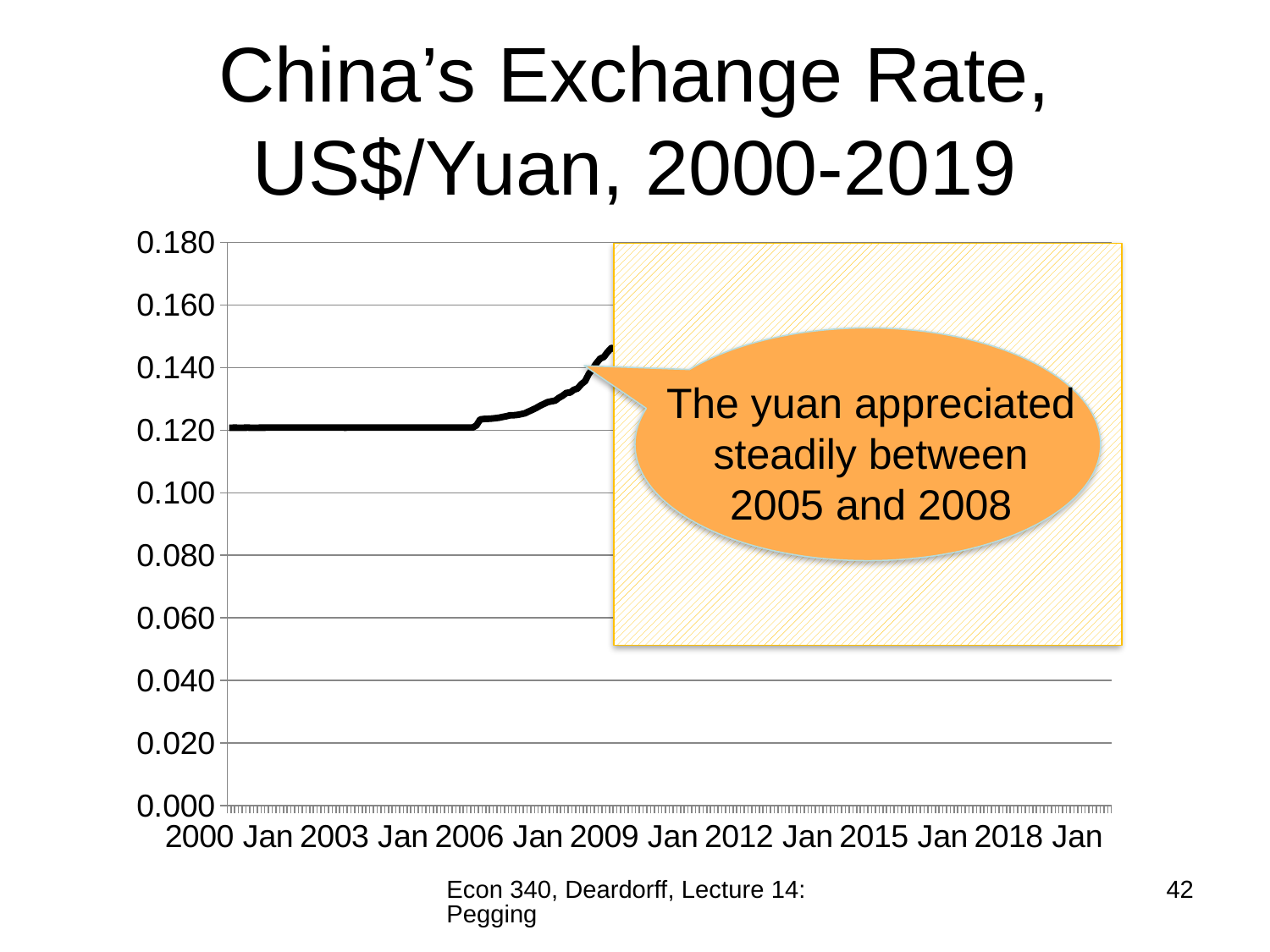
What is the title of the chart? China's Exchange Rate, US$/Yuan, 2000-2019 Is the value for 2003 Jan greater or less than 0.140? less Which is larger, the exchange rate in 2003 Jan or the exchange rate in 2008? 2008 What is the highest value shown on the y axis? 0.180 Is the value for 2000 Jan greater or less than 0.160? less Is the value for 2003 Jan greater or less than 0.100? greater What kind of chart is shown on the slide? line chart Does the exchange rate rise or fall between 2005 and 2008? rises How many year labels are shown on the x axis? 7 Does the exchange rate rise, fall, or stay flat between 2000 Jan and 2005? stays flat What does the callout on the chart say? The yuan appreciated steadily between 2005 and 2008